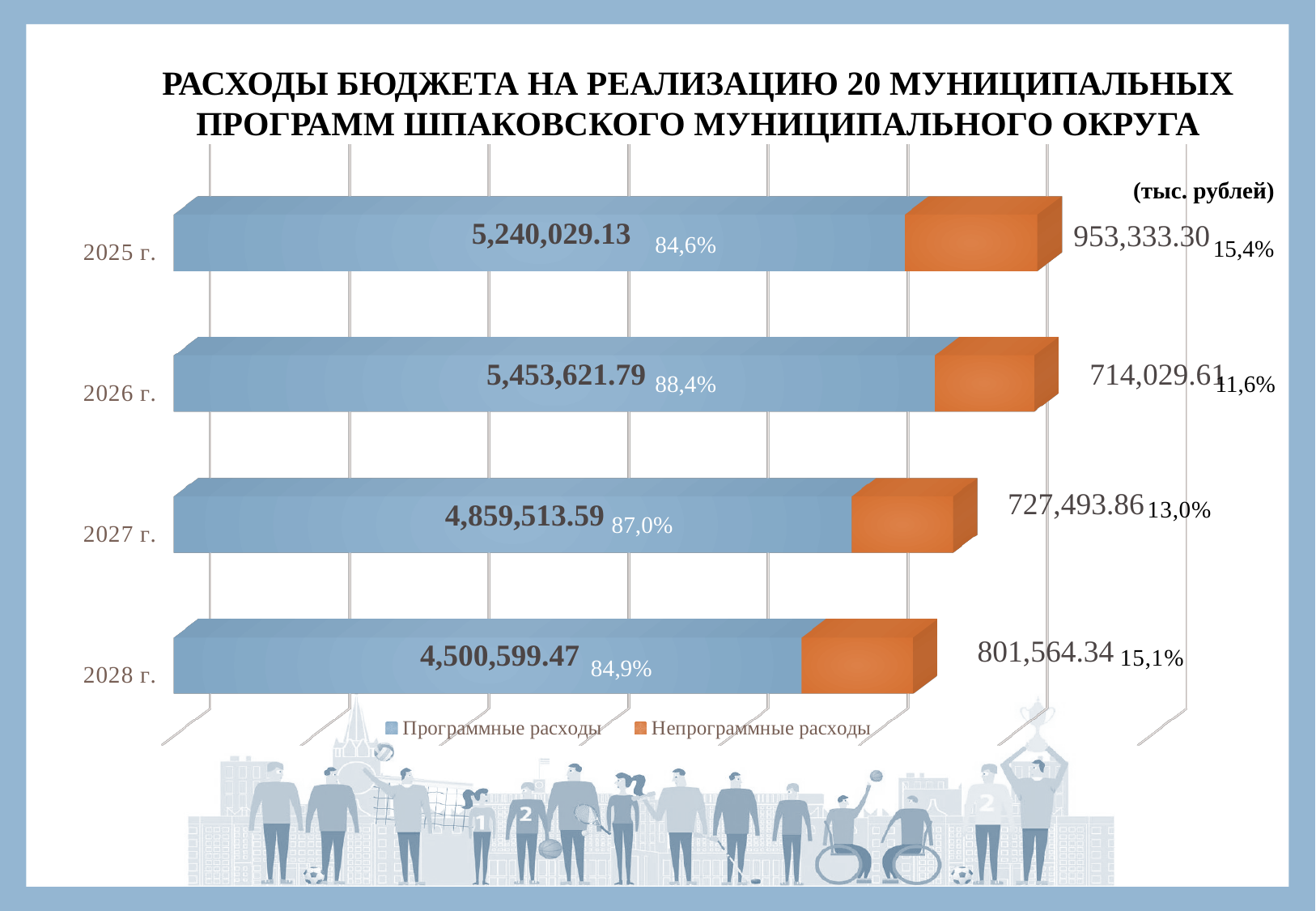
What percentage share is shown for Программные расходы in 2028 г.? 84,9% Do the values of Программные расходы rise or fall from 2026 г. to 2028 г.? Fall What kind of chart is shown on the slide? Stacked bar chart Which year has the highest value of Программные расходы? 2026 г. Which year has the lowest value of Непрограммные расходы? 2026 г. What is the difference between Программные расходы in 2026 г. and 2025 г.? 213,592.66 What is the value of Программные расходы for 2026 г.? 5,453,621.79 Which year has the larger value of Непрограммные расходы, 2027 г. or 2028 г.? 2028 г. What is the value of Непрограммные расходы for 2027 г.? 727,493.86 How many series does the legend list? 2 How many years (categories) are shown in the chart? 4 What is the total of the stacked bar for 2025 г.? 6,193,362.43